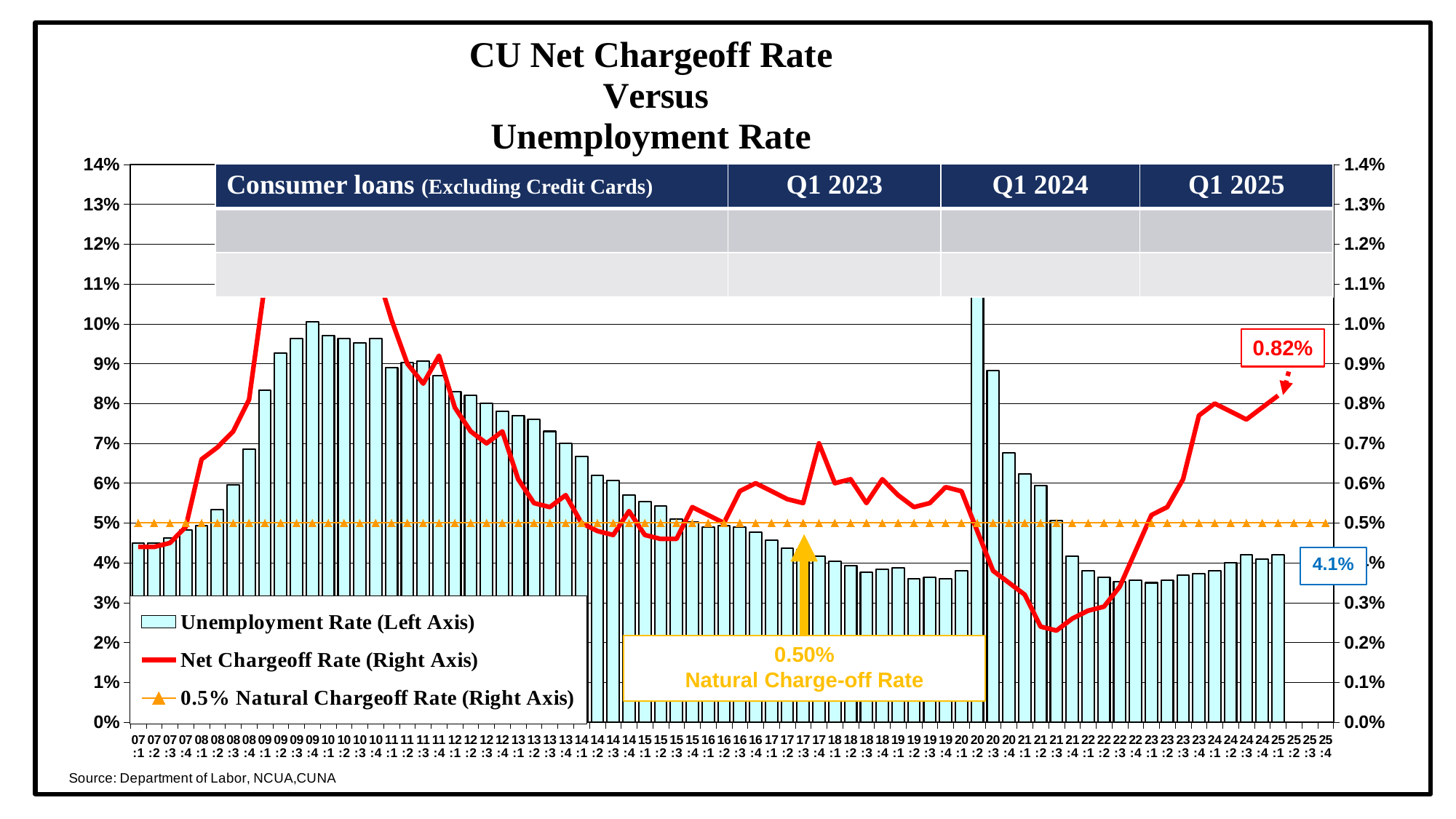
What kind of chart is shown on the slide? A combined bar and line chart Is the Unemployment Rate for 20:2 greater or less than 10%? greater What is the Net Chargeoff Rate labelled at the end of the series (25:1)? 0.82% What value is the Natural Chargeoff Rate line set at? 0.50% Is the Net Chargeoff Rate for 21:3 greater or less than 0.3%? less Is the Net Chargeoff Rate for 17:4 greater or less than 0.6%? greater Does the Net Chargeoff Rate rise or fall from 22:3 to 25:1? rise What is the title of the chart? CU Net Chargeoff Rate Versus Unemployment Rate What is the Unemployment Rate labelled at the end of the series (25:1)? 4.1% How many series does the legend list? 3 Which quarter has the highest Unemployment Rate bar? 20:2 Which is larger, the Unemployment Rate for 20:2 or for 21:1? 20:2